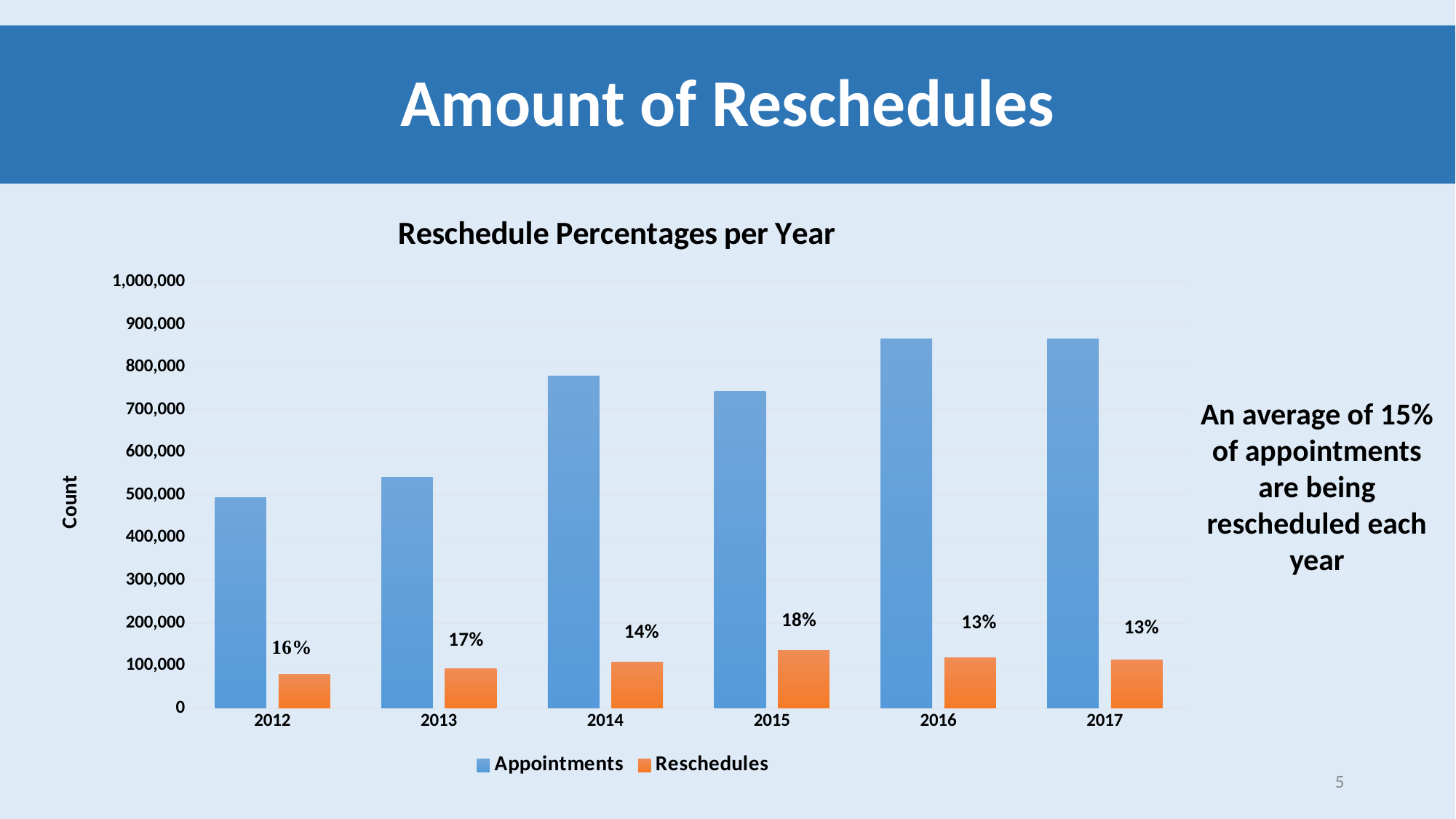
What percentage label is shown on the Reschedules bar for 2012? 16% Which year has the lowest Appointments bar? 2012 How many series does the chart legend list? 2 What is the difference between the reschedule percentage labels for 2015 and 2012? 2 percentage points Which year has the highest reschedule percentage label? 2015 Which year has the larger Appointments bar, 2014 or 2015? 2014 How many years are shown on the x axis of the chart? 6 What percentage label is shown on the Reschedules bar for 2015? 18% Is the Appointments value for 2014 greater or less than 700,000? greater Is the Appointments value for 2012 greater or less than 600,000? less What type of chart is shown on the slide? Bar chart Is the Reschedules value for 2015 greater or less than 100,000? greater